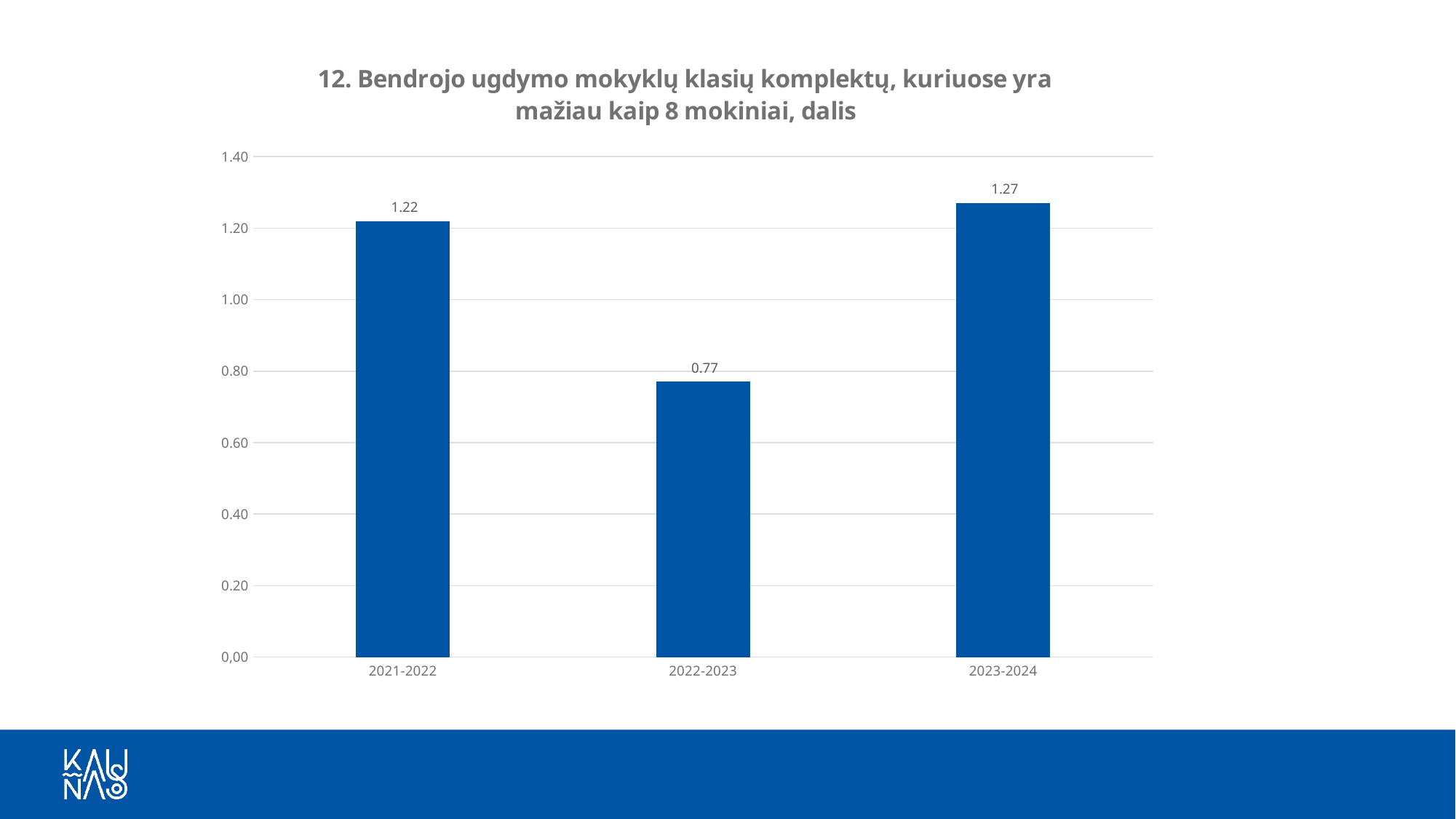
What is the value for 2023-2024? 1.27 Which is larger, the value for 2021-2022 or the value for 2022-2023? 2021-2022 What is the difference between the values for 2023-2024 and 2022-2023? 0.50 Which school year has the highest value? 2023-2024 What is the title of the chart? 12. Bendrojo ugdymo mokyklų klasių komplektų, kuriuose yra mažiau kaip 8 mokiniai, dalis What is the difference between the values for 2021-2022 and 2022-2023? 0.45 How many school years are shown on the chart? 3 What kind of chart is shown on the slide? bar chart Which school year has the lowest value? 2022-2023 What is the value for 2021-2022? 1.22 What is the value for 2022-2023? 0.77 Is the value for 2022-2023 greater or less than 1.00? less